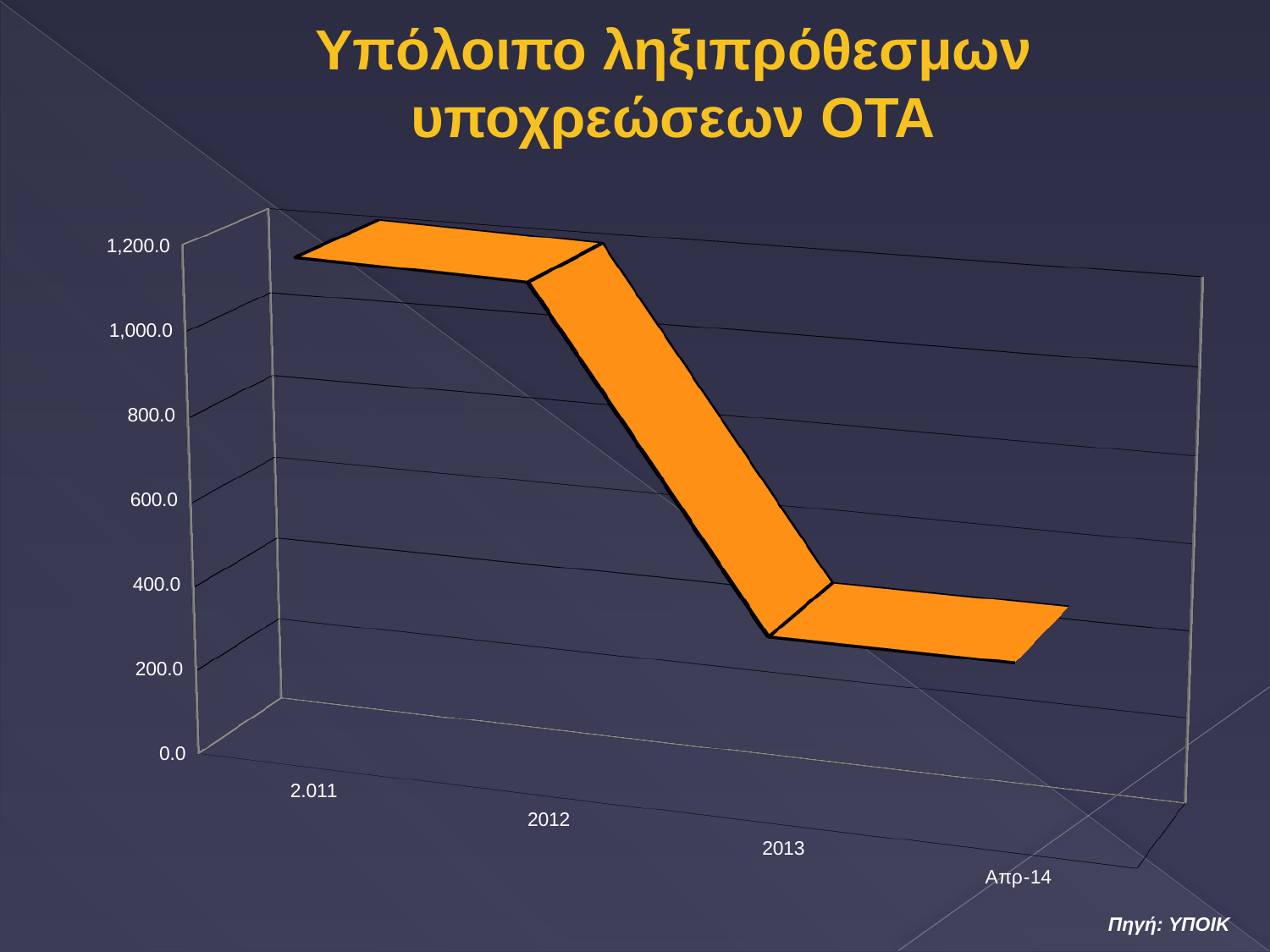
Is the value for 2.011 greater or less than 800.0? greater Which time point has the highest value? 2.011 What kind of chart is shown on the slide? line chart Which is larger, the value for 2.011 or the value for Απρ-14? 2.011 Is the value for 2013 greater or less than 600.0? less Is the value for Απρ-14 greater or less than 600.0? less What source is cited for the chart? ΥΠΟΙΚ Which is larger, the value for 2012 or the value for 2013? 2012 How many time points are plotted along the x axis? 4 What is the title of the chart? Υπόλοιπο ληξιπρόθεσμων υποχρεώσεων ΟΤΑ Do the values rise or fall from 2.011 to Απρ-14? fall